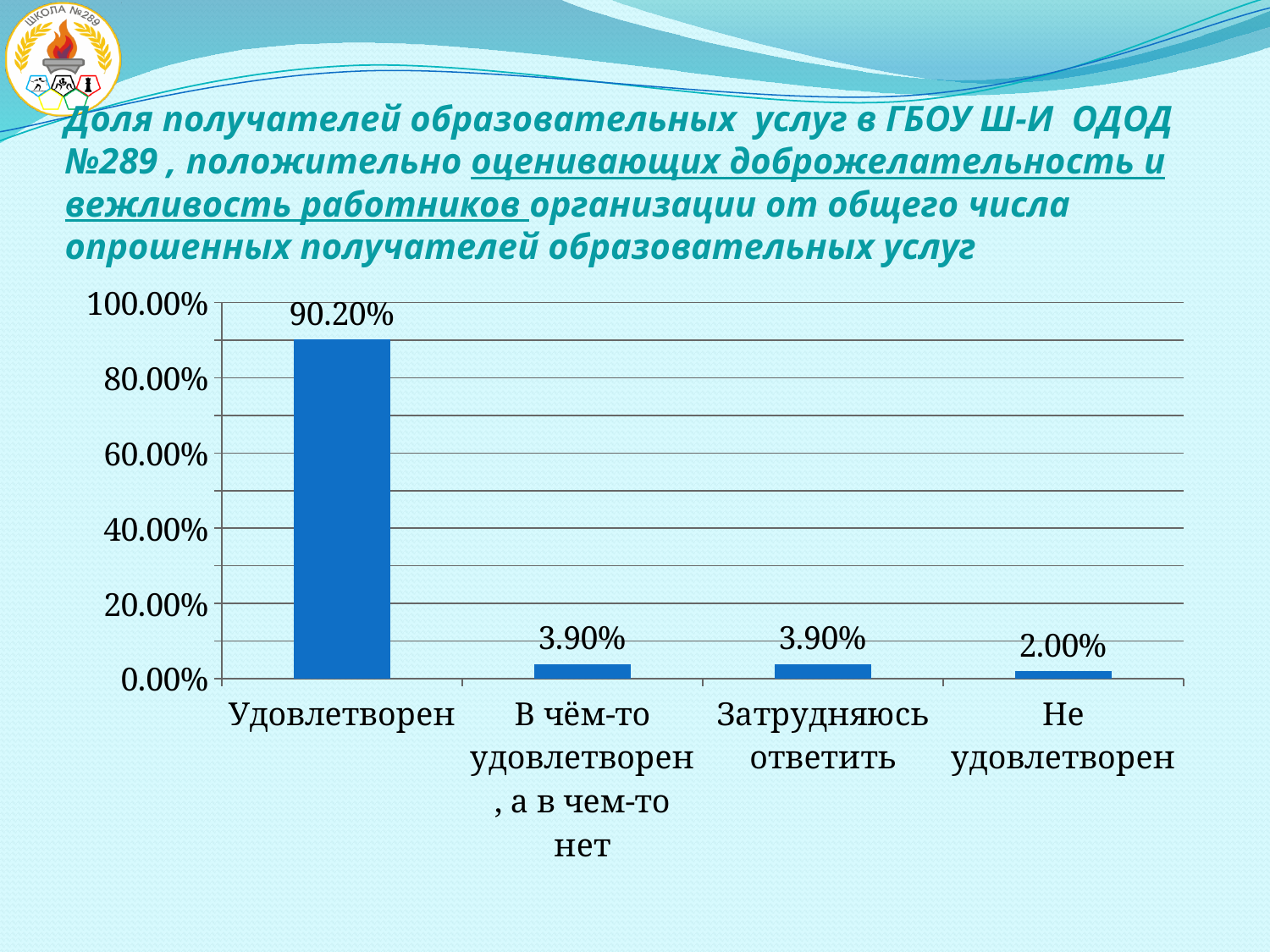
What is the difference between the values for "Удовлетворен" and "Не удовлетворен"? 88.20% What is the value for "Удовлетворен"? 90.20% What kind of chart is shown on the slide? bar chart What is the value for "Затрудняюсь ответить"? 3.90% Which category has the lowest value? Не удовлетворен How many categories are shown on the chart? 4 What is the difference between the values for "Затрудняюсь ответить" and "Не удовлетворен"? 1.90% What is the value for "Не удовлетворен"? 2.00% Which is larger, the value for "Удовлетворен" or the value for "Затрудняюсь ответить"? Удовлетворен Is the value for "Удовлетворен" greater or less than 80.00%? greater Which category has the highest value? Удовлетворен What is the value for "В чём-то удовлетворен, а в чем-то нет"? 3.90%